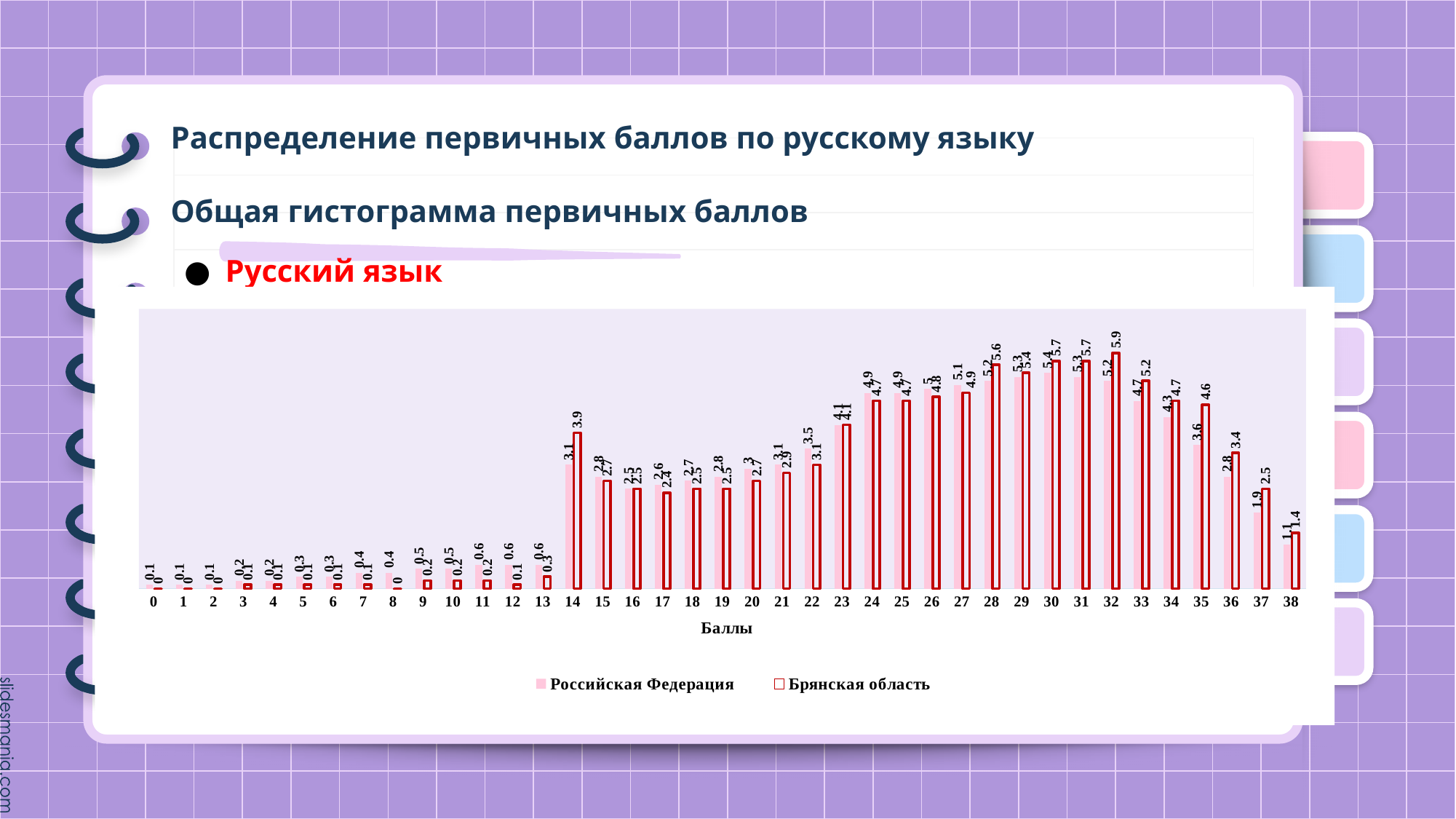
What are the two series named in the chart legend? Российская Федерация and Брянская область How many score categories (Баллы) are shown on the x axis? 39 What is the value for Российская Федерация at score 30? 5.4 At score 22, which series has the larger value, Российская Федерация or Брянская область? Российская Федерация What is the value for Брянская область at score 14? 3.9 What is the x-axis title of the chart? Баллы At which score does Брянская область reach its highest value? 32 What is the difference between Брянская область and Российская Федерация at score 35? 1 What type of chart is shown on the slide? Bar chart What is the value for Брянская область at score 38? 1.4 How many series does the chart legend list? 2 What is the highest value for Российская Федерация? 5.4